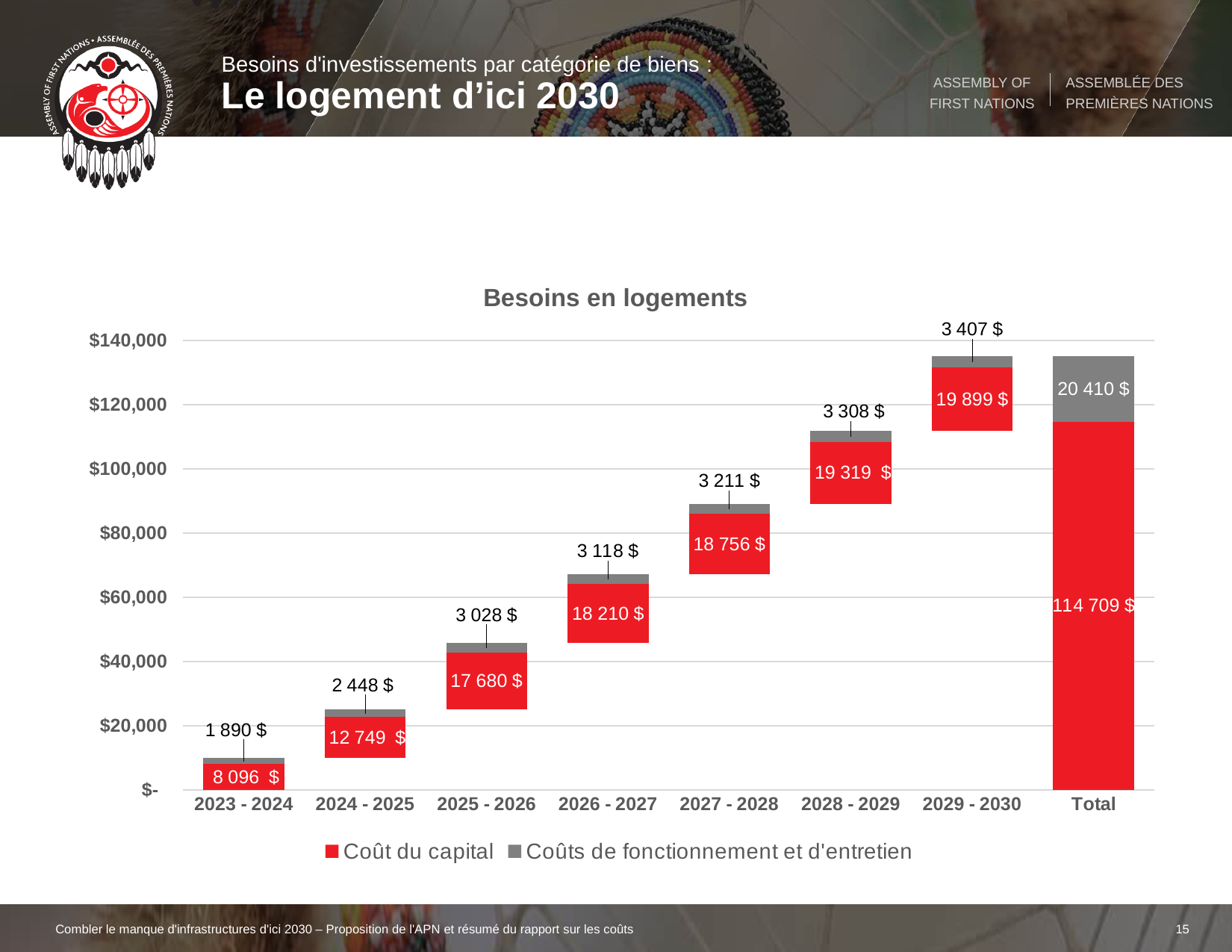
What kind of chart is shown on the slide? Stacked bar chart What is the Coût du capital value for 2025 - 2026? 17 680 $ What is the Coût du capital value shown for the Total bar? 114 709 $ Which year has the lowest Coûts de fonctionnement et d'entretien? 2023 - 2024 Do the Coût du capital values rise or fall from 2023 - 2024 to 2029 - 2030? Rise How many series does the legend list? 2 Excluding the Total bar, which year has the highest Coût du capital? 2029 - 2030 What is the difference between the Coût du capital for 2029 - 2030 and for 2023 - 2024? 11 803 $ What is the Coûts de fonctionnement et d'entretien value for 2029 - 2030? 3 407 $ How many categories are shown on the x axis? 8 What is the combined value of the two segments in the Total bar? 135 119 $ Which is larger, the Coût du capital for 2026 - 2027 or for 2024 - 2025? 2026 - 2027